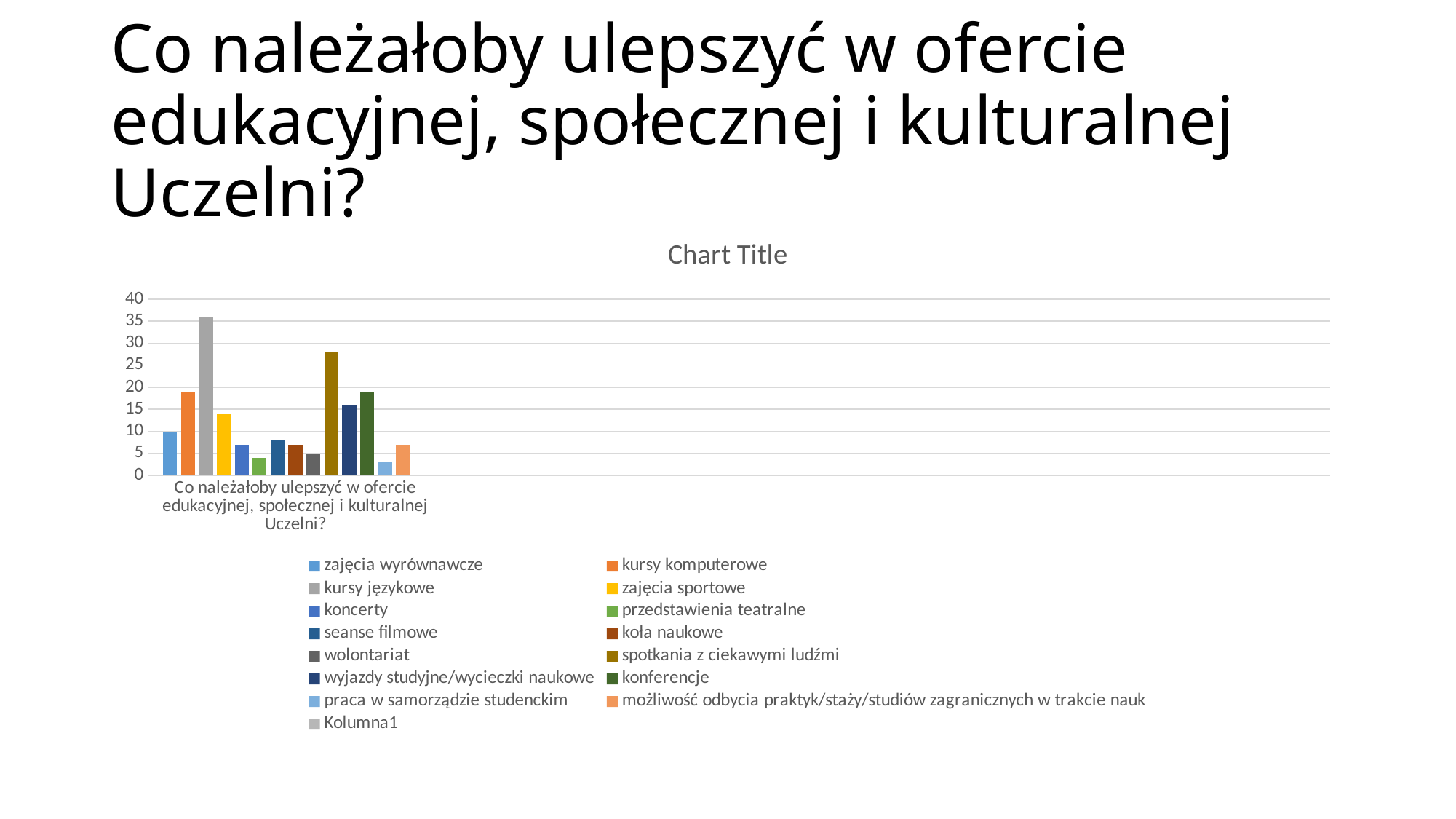
Is the value for wolontariat greater or less than 10? less What is the title shown above the chart? Chart Title Which is larger, the value for konferencje or the value for wyjazdy studyjne/wycieczki naukowe? konferencje What is the highest value shown on the vertical axis? 40 Is the value for zajęcia sportowe greater or less than 10? greater What kind of chart is shown on the slide? bar chart Which series has the highest bar? kursy językowe Which is larger, the value for kursy komputerowe or the value for zajęcia sportowe? kursy komputerowe Is the value for kursy językowe greater or less than 30? greater How many series does the legend list? 15